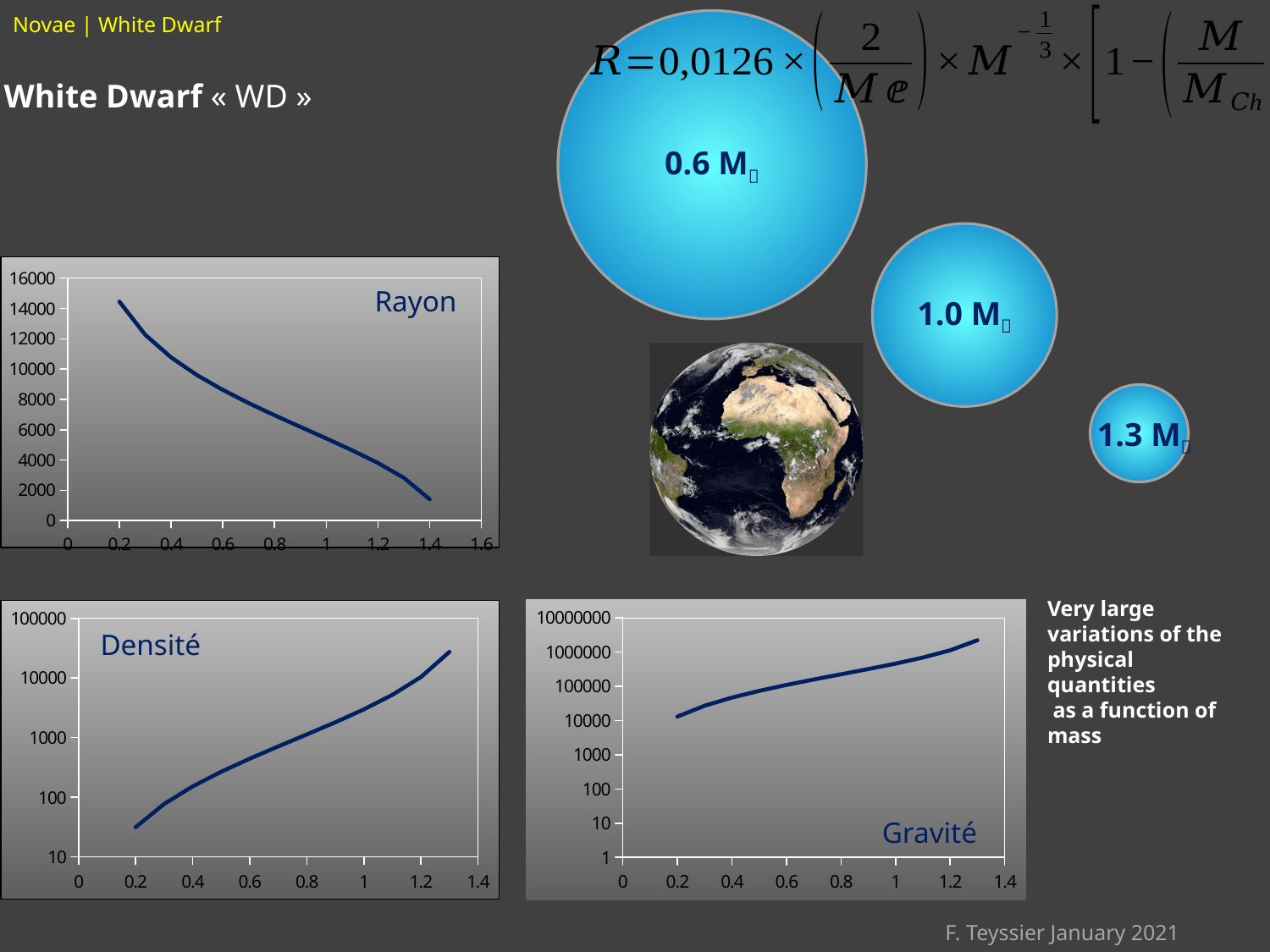
In the Densité chart, is the value at x = 0.2 greater or less than 100? less In the Gravité chart, do the values rise or fall as the x axis increases? rise In the Rayon chart, do the values rise or fall as the x axis increases? fall In the Rayon chart, is the value at x = 0.6 greater or less than 6000? greater In the Densité chart, is the value at x = 1.3 greater or less than 10000? greater In the Densité chart, do the values rise or fall as the x axis increases? rise What is the highest value shown on the y axis of the Gravité chart? 10000000 What kind of chart is the Rayon chart? line chart